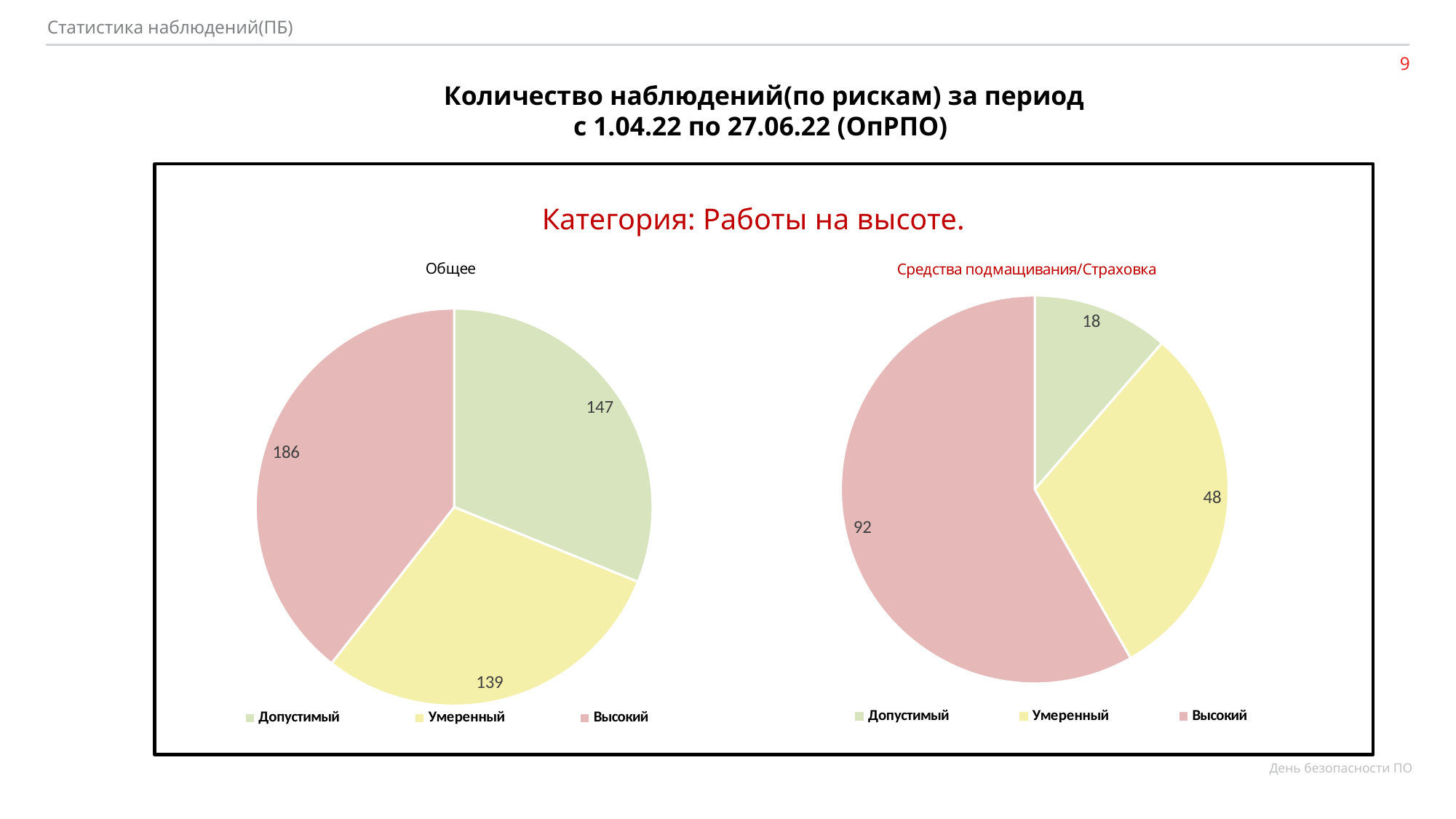
In the "Общее" pie chart, what is the value for Высокий? 186 In the "Средства подмащивания/Страховка" pie chart, which category has the smallest value? Допустимый In the "Средства подмащивания/Страховка" pie chart, what is the difference between the values for Высокий and Допустимый? 74 In the "Общее" pie chart, which is larger: Допустимый or Умеренный? Допустимый In the "Средства подмащивания/Страховка" pie chart, what is the value for Умеренный? 48 How many slices does the "Средства подмащивания/Страховка" pie chart have? 3 In the "Средства подмащивания/Страховка" pie chart, what is the value for Допустимый? 18 In the "Общее" pie chart, what is the difference between the values for Высокий and Умеренный? 47 In the "Общее" pie chart, which category has the largest value? Высокий What type of chart is the "Общее" chart? Pie chart In the "Общее" pie chart, what is the value for Допустимый? 147 What is the total of all slices in the "Средства подмащивания/Страховка" pie chart? 158